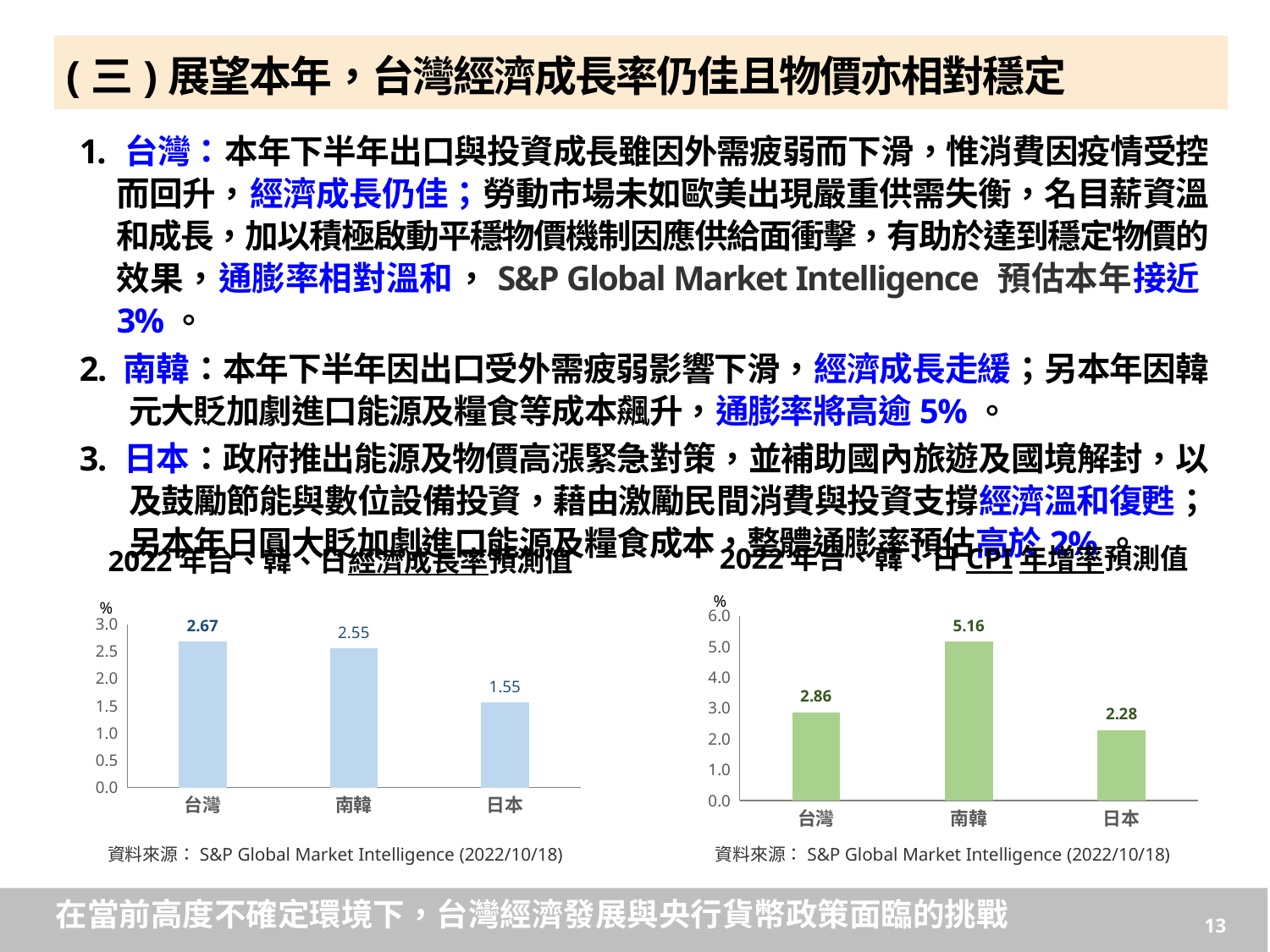
How many categories are shown in the left chart (2022 economic growth rate forecasts)? 3 In the right chart (2022 CPI annual growth rate forecasts), what is the value for 南韓? 5.16 In the left chart (2022 economic growth rate forecasts), what is the difference between the values for 台灣 and 日本? 1.12 In the left chart (2022 economic growth rate forecasts), what is the value for 台灣? 2.67 In the left chart (2022 economic growth rate forecasts), which category has the lowest value? 日本 In the right chart (2022 CPI annual growth rate forecasts), what is the difference between the values for 南韓 and 日本? 2.88 In the right chart (2022 CPI annual growth rate forecasts), what is the value for 台灣? 2.86 In the right chart (2022 CPI annual growth rate forecasts), which category has the lowest value? 日本 What type of chart is the right chart (2022 CPI annual growth rate forecasts)? bar chart In the right chart (2022 CPI annual growth rate forecasts), which category has the highest value? 南韓 In the right chart (2022 CPI annual growth rate forecasts), which is larger, the value for 台灣 or the value for 日本? 台灣 In the left chart (2022 economic growth rate forecasts), what is the value for 日本? 1.55